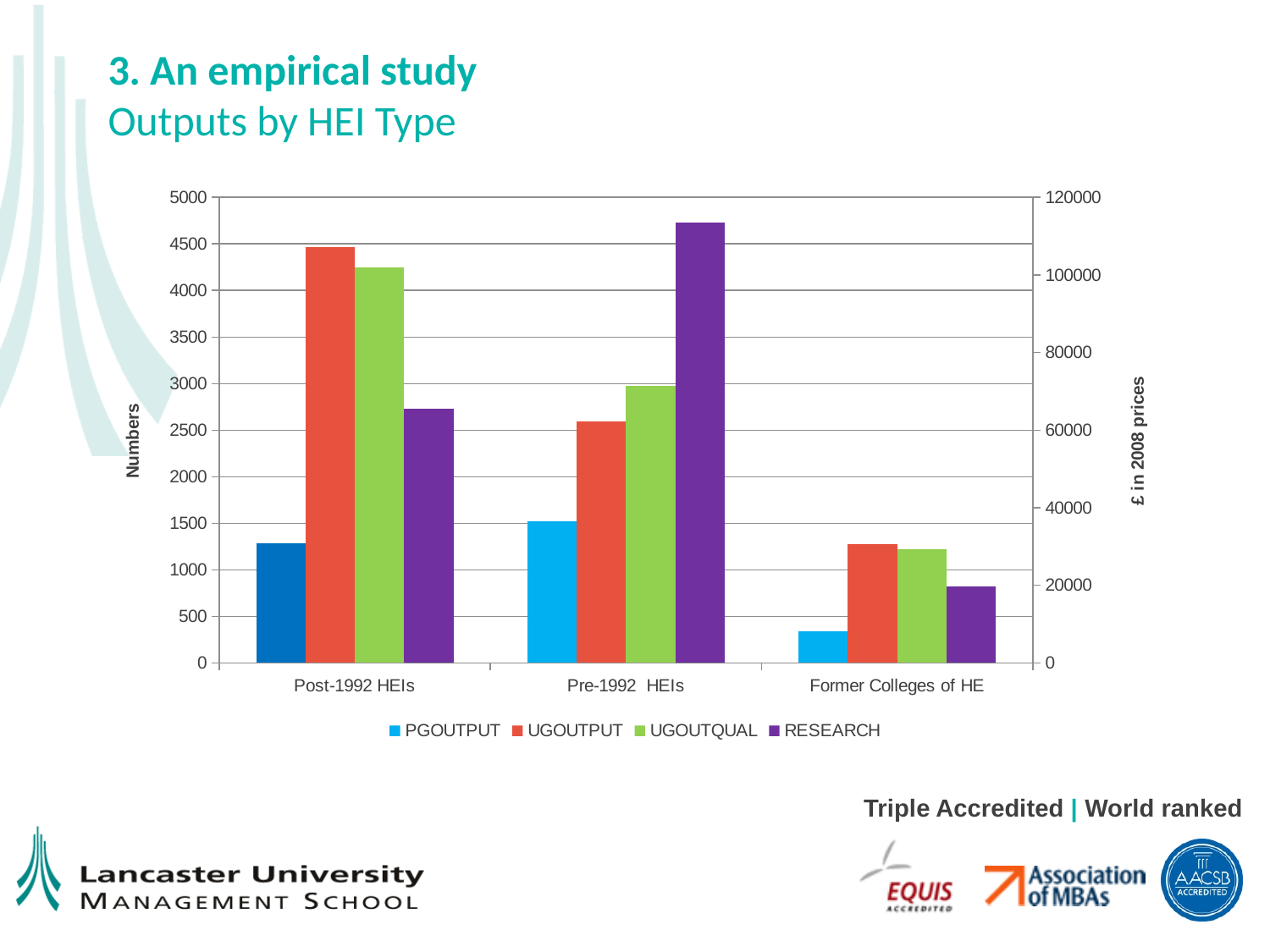
Read against the left axis, is the UGOUTPUT bar for Former Colleges of HE greater or less than 1500? less Which HEI type has the tallest UGOUTPUT bar? Post-1992 HEIs What kind of chart is shown on the slide? bar chart Which HEI type has the tallest RESEARCH bar? Pre-1992 HEIs What is the label of the right vertical axis? £ in 2008 prices How many HEI type categories are shown on the x axis? 3 For Post-1992 HEIs, which is taller: the UGOUTPUT bar or the PGOUTPUT bar? UGOUTPUT How many series does the legend list? 4 What is the label of the left vertical axis? Numbers Read against the left axis, is the PGOUTPUT bar for Post-1992 HEIs greater or less than 1000? greater Which HEI type has the shortest PGOUTPUT bar? Former Colleges of HE For Pre-1992 HEIs, which is taller: the RESEARCH bar or the UGOUTQUAL bar? RESEARCH